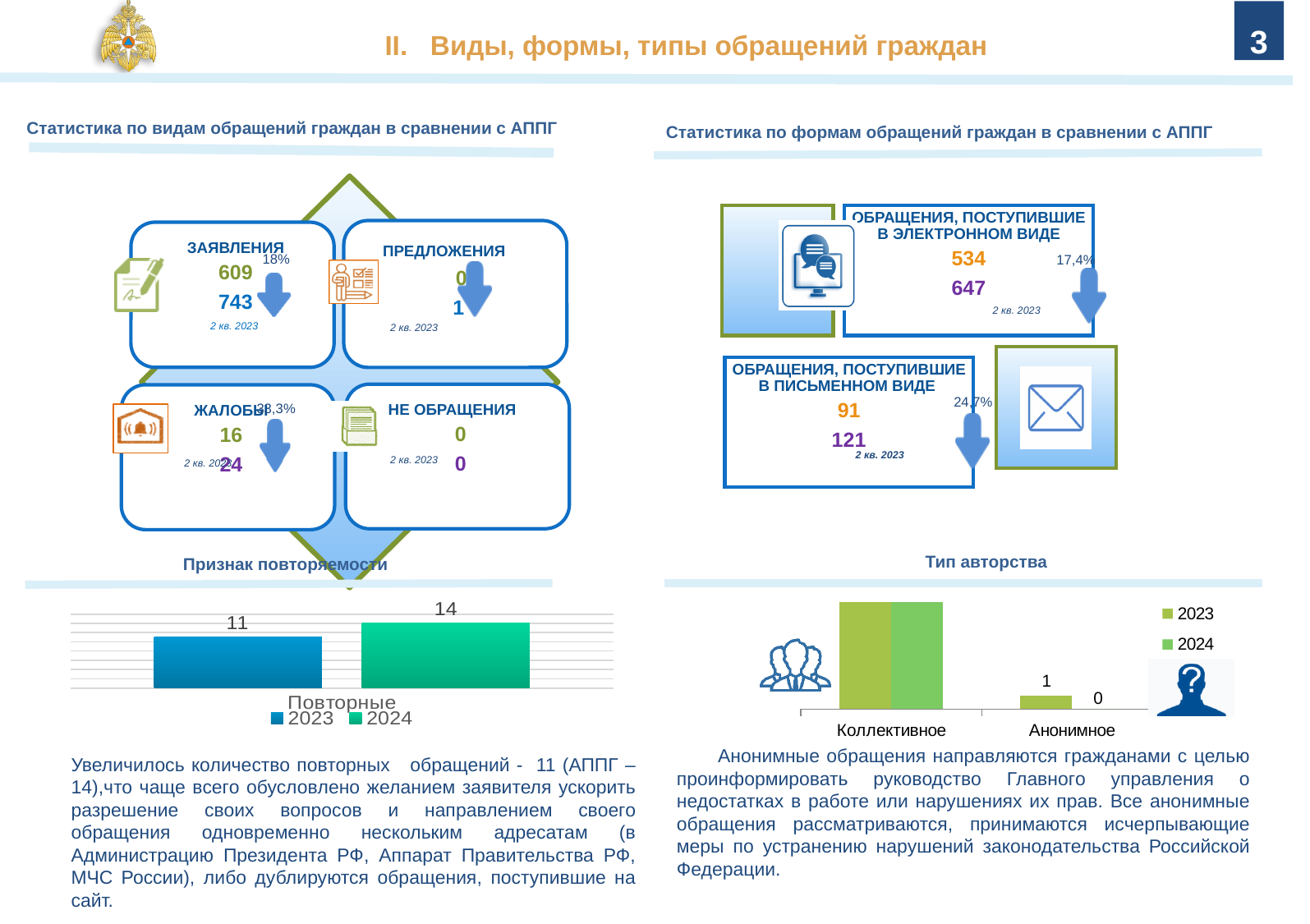
In the 'Тип авторства' chart, what is the 2024 value for Анонимное? 0 In the 'Признак повторяемости' chart, what is the difference between the 2024 and 2023 values? 3 What kind of chart is the 'Признак повторяемости' chart? Bar chart How many series does the legend of the 'Тип авторства' chart list? 2 In the 'Признак повторяемости' chart, which year has the larger value, 2023 or 2024? 2024 How many categories are shown on the x axis of the 'Тип авторства' chart? 2 What is the single category label on the x axis of the 'Признак повторяемости' chart? Повторные In the 'Тип авторства' chart, what is the 2023 value for Анонимное? 1 In the 'Признак повторяемости' chart, what is the value for 2023? 11 In the 'Тип авторства' chart, which category has the higher bars, Коллективное or Анонимное? Коллективное In the 'Признак повторяемости' chart, what is the value for 2024? 14 How many series does the legend of the 'Признак повторяемости' chart list? 2